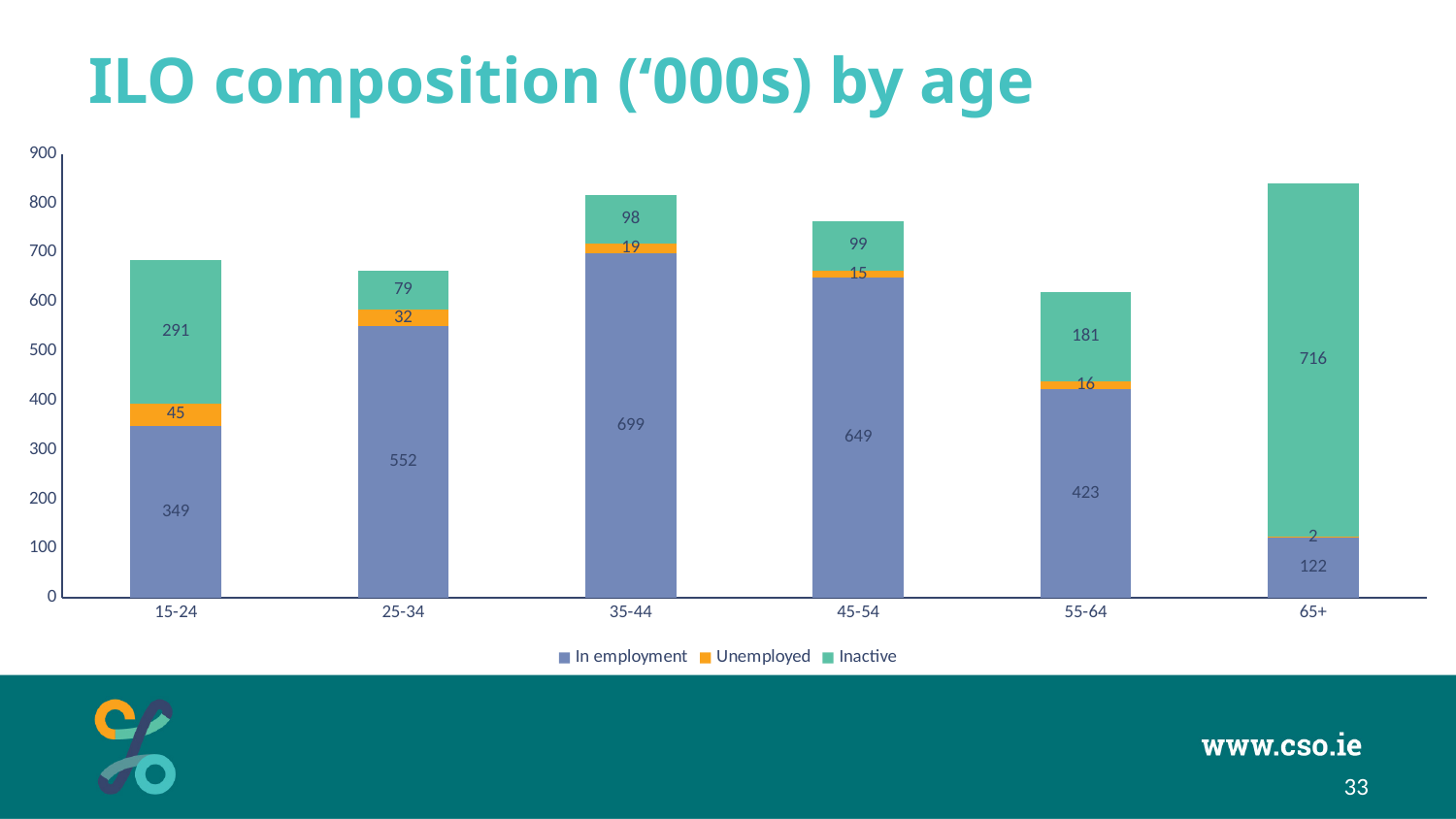
Which is larger, the Inactive value for 15-24 or the Inactive value for 55-64? 15-24 Which age group has the highest In employment value? 35-44 What is the total of the stacked bar for the 15-24 age group? 685 Which age group has the lowest Unemployed value? 65+ What is the total of the stacked bar for the 65+ age group? 840 What is the difference between the In employment values for 25-34 and 55-64? 129 What is the In employment value for the 35-44 age group? 699 What is the Unemployed value for the 15-24 age group? 45 What is the Inactive value for the 65+ age group? 716 How many series does the legend list? 3 How many age groups are shown on the x axis? 6 What kind of chart is shown on the slide? Stacked bar chart